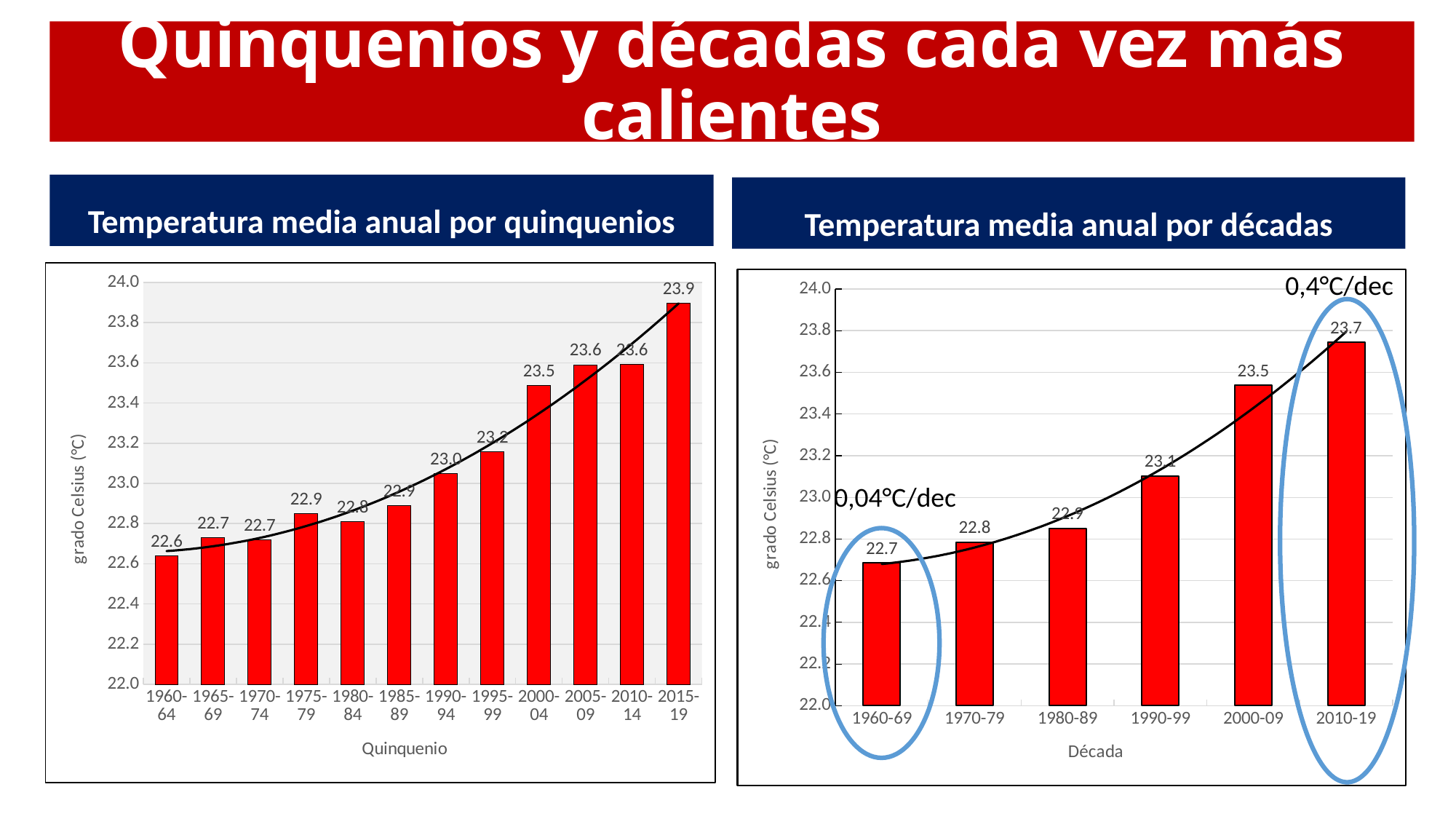
In the chart 'Temperatura media anual por quinquenios', how many quinquenios are shown on the x axis? 12 In the chart 'Temperatura media anual por décadas', which década has the lowest value? 1960-69 In the chart 'Temperatura media anual por décadas', what is the difference between the values for 2010-19 and 1960-69? 1.0 In the chart 'Temperatura media anual por quinquenios', what is the value for 2015-19? 23.9 In the chart 'Temperatura media anual por décadas', which is larger, the value for 1990-99 or the value for 2000-09? 2000-09 In the chart 'Temperatura media anual por quinquenios', what is the difference between the values for 2015-19 and 1960-64? 1.3 In the chart 'Temperatura media anual por décadas', how many décadas are shown? 6 In the chart 'Temperatura media anual por décadas', what is the value for 2000-09? 23.5 In the chart 'Temperatura media anual por quinquenios', what is the value for 1960-64? 22.6 In the chart 'Temperatura media anual por quinquenios', which quinquenio has the highest value? 2015-19 In the chart 'Temperatura media anual por quinquenios', do the values generally rise or fall from 1960-64 to 2015-19? rise What kind of chart is 'Temperatura media anual por décadas'? bar chart